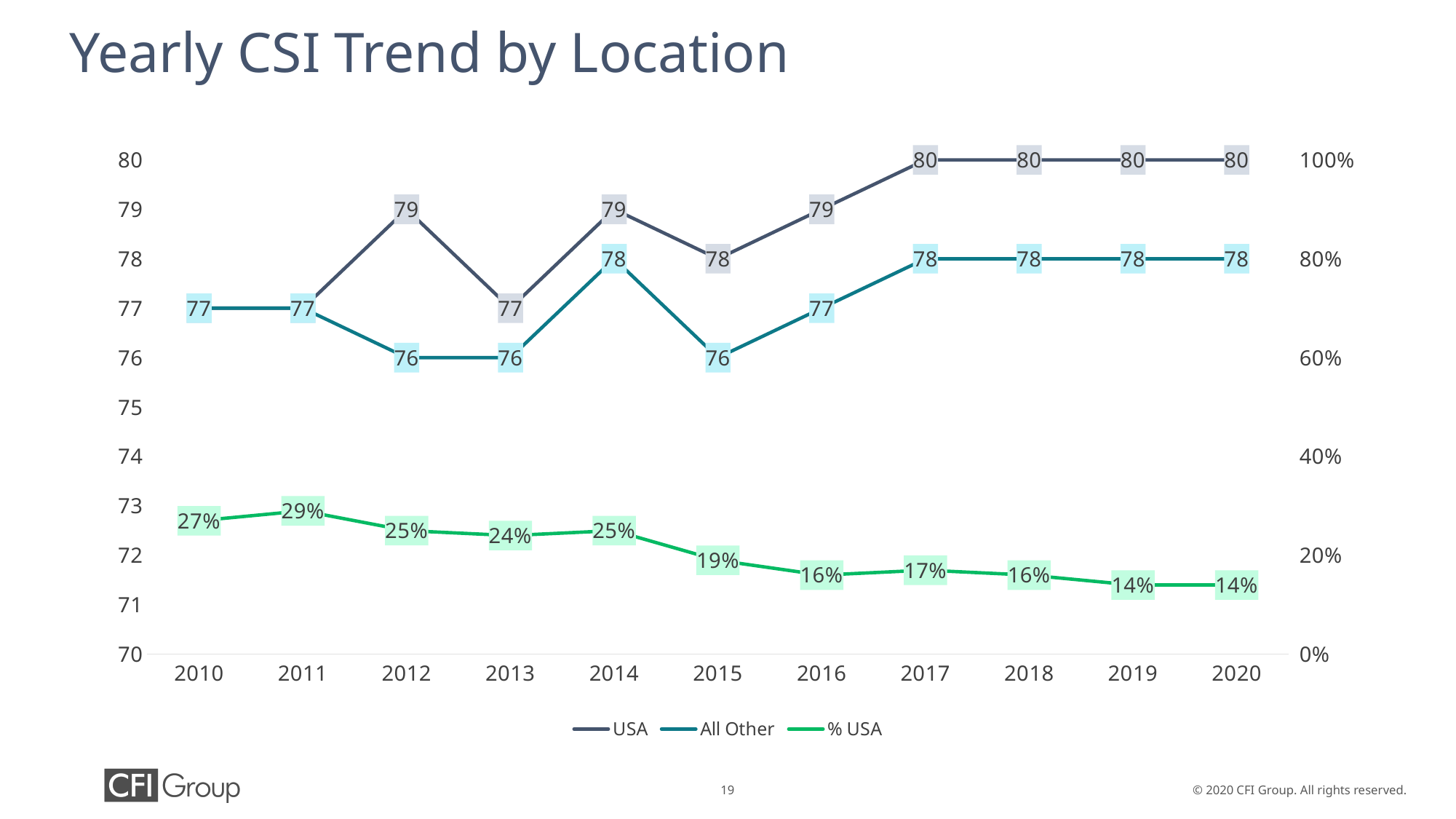
How many years are shown on the x axis? 11 How many series does the legend list? 3 What is the title of the chart? Yearly CSI Trend by Location What is the % USA value for 2011? 29% What is the difference between the USA and All Other CSI values in 2015? 2 What is the All Other CSI value for 2015? 76 What is the lowest value shown for the All Other series? 76 Which series has the higher value in 2016, USA or All Other? USA What is the USA CSI value for 2012? 79 In which year is the % USA value highest? 2011 What kind of chart is shown on the slide? Line chart Does the % USA series generally rise or fall from 2010 to 2020? Fall